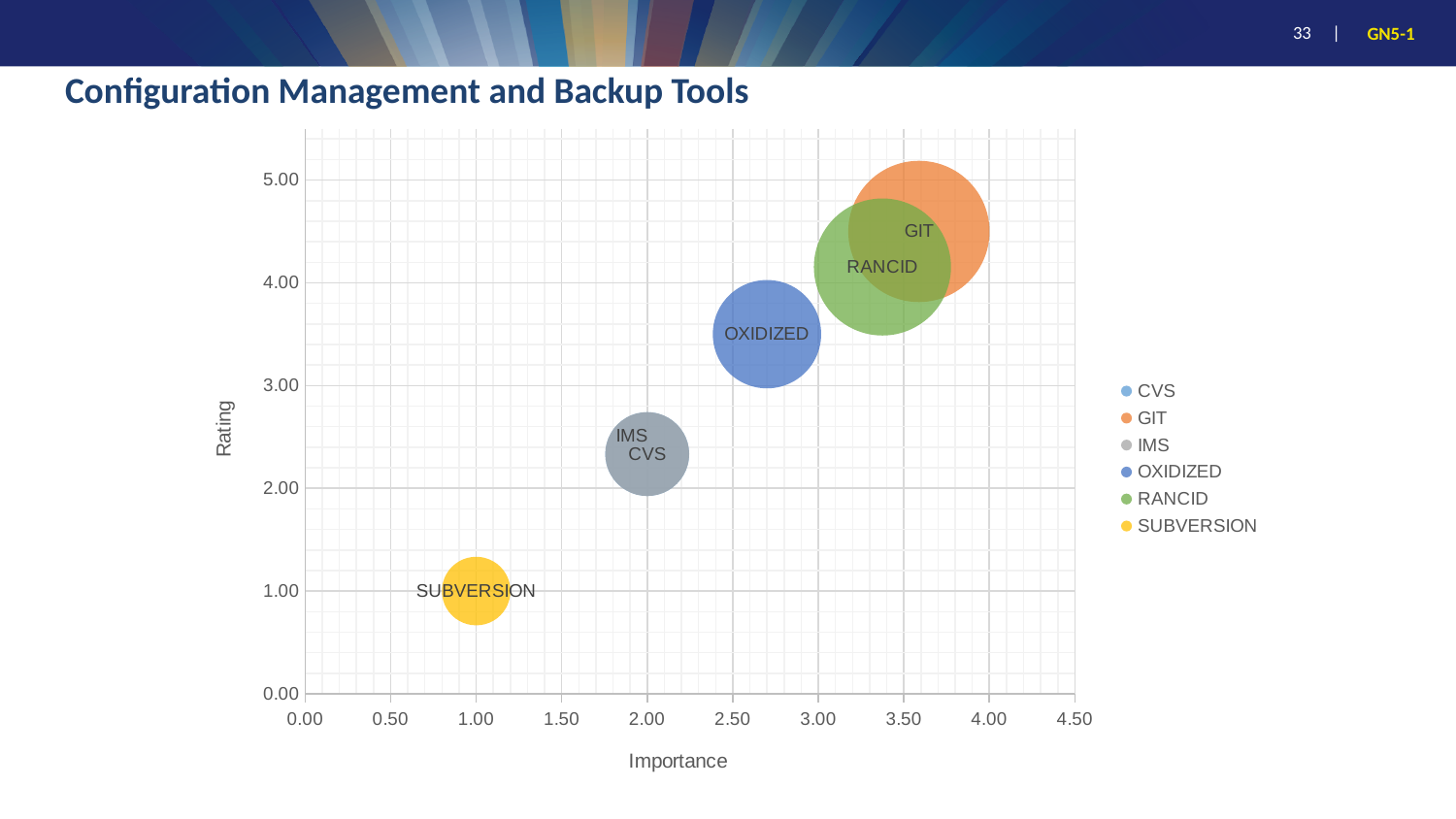
Which has the higher importance, IMS or RANCID? RANCID How many series does the legend list? 6 Is the rating for SUBVERSION greater or less than 2.00? less Is the rating for GIT greater or less than 4.00? greater Which tool has the lowest importance? SUBVERSION Which tool has the highest rating? GIT Which has the higher rating, OXIDIZED or SUBVERSION? OXIDIZED Is the importance for OXIDIZED greater or less than 2.50? greater What is the title of the chart? Configuration Management and Backup Tools What is the label of the horizontal axis? Importance What kind of chart is shown on the slide? bubble chart Which tool has the lowest rating? SUBVERSION